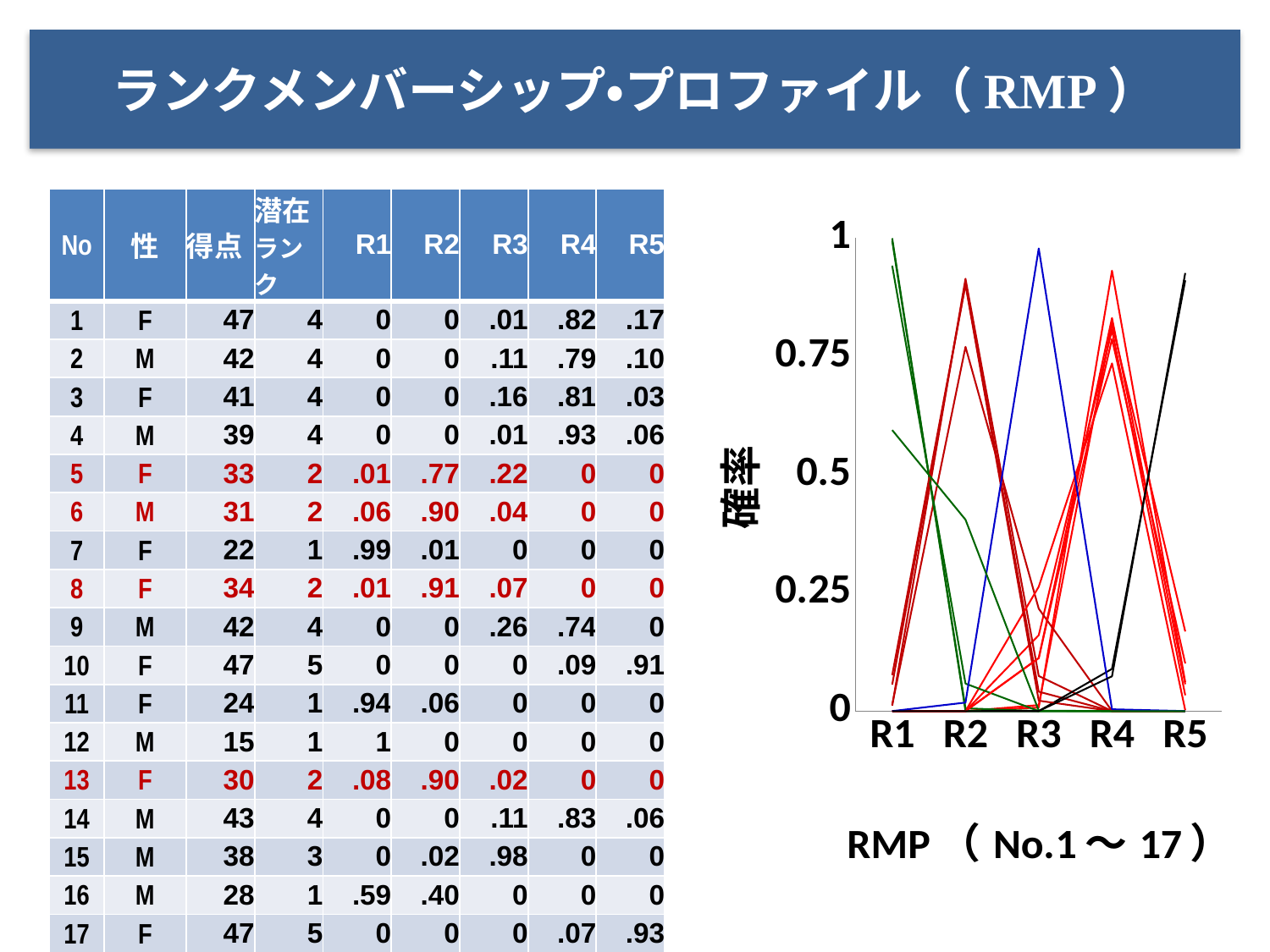
Is the highest green line value at R1 greater or less than 0.75? greater How many categories are shown on the x axis of the chart? 5 Does the black line rise or fall from R4 to R5? rise Is the value of the blue line at R1 greater or less than 0.25? less Is the value of the black line at R5 greater or less than 0.75? greater What is the highest tick value shown on the y axis of the chart? 1 What kind of chart is shown on the right of the slide? line chart What is the label of the last category on the x axis of the chart? R5 Does the blue line rise or fall from R3 to R4? fall What is the label of the first category on the x axis of the chart? R1